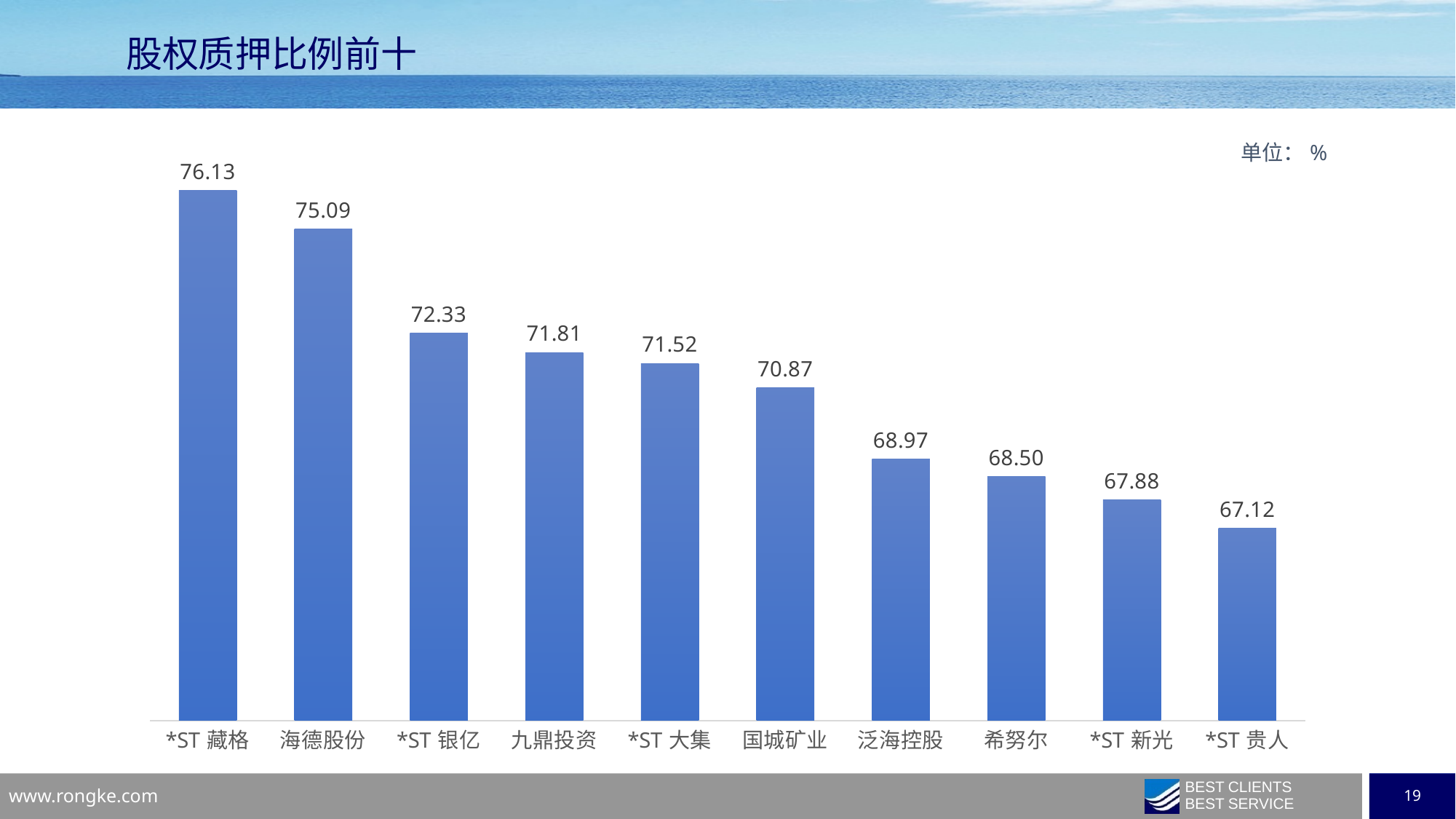
Do the values rise or fall from left to right along the x axis? fall What is the value for *ST 藏格? 76.13 Which category has the lowest value? *ST 贵人 What kind of chart is this? bar chart What is the title of the chart? 股权质押比例前十 Which category has the highest value? *ST 藏格 What is the value for 国城矿业? 70.87 What is the value for 希努尔? 68.50 Which is larger, the value for 九鼎投资 or the value for *ST 大集? 九鼎投资 How many categories are shown in the chart? 10 What is the difference between the values for *ST 藏格 and 海德股份? 1.04 What is the difference between the values for 泛海控股 and *ST 新光? 1.09